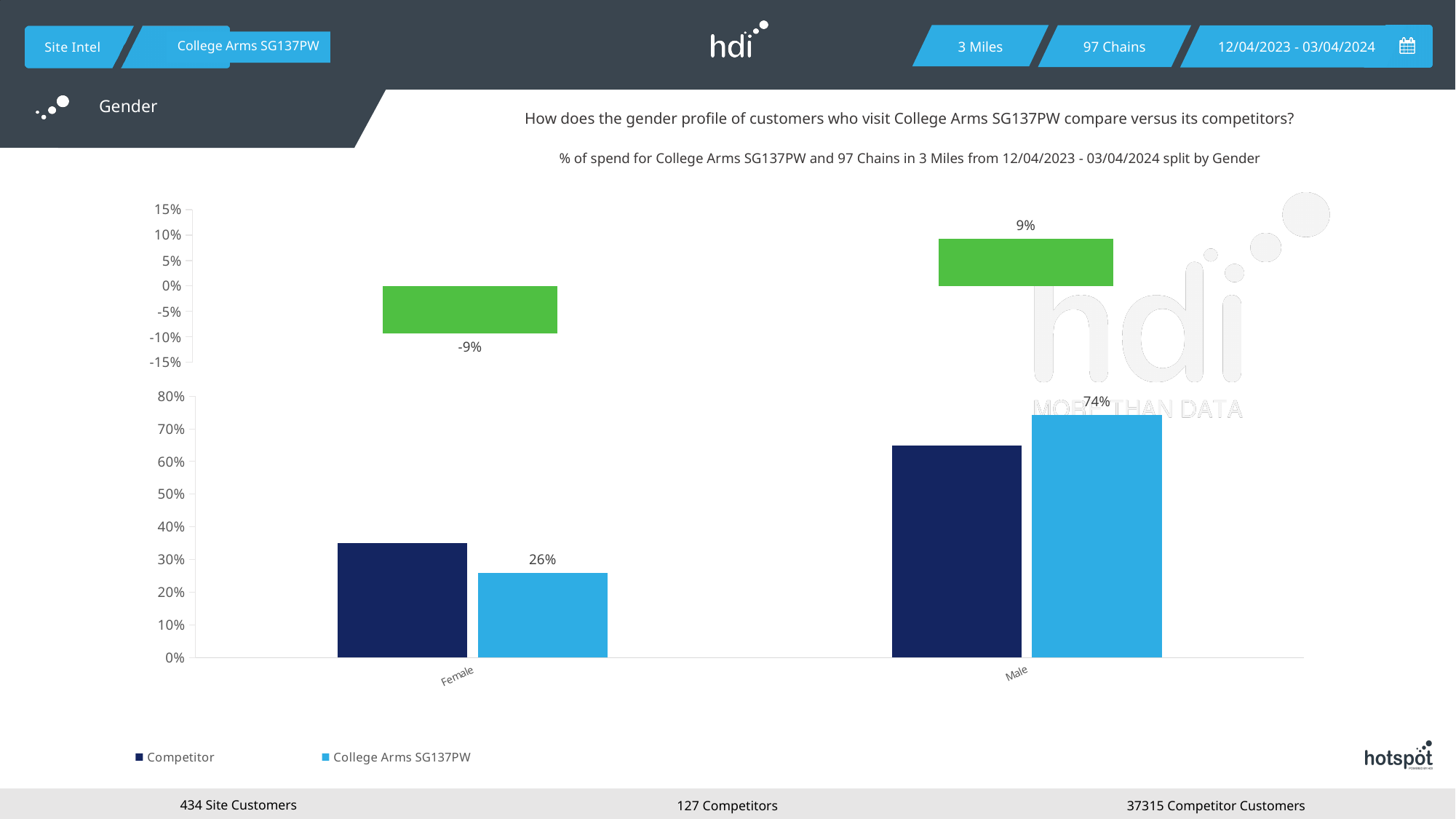
In the bottom bar chart, what is the value for College Arms SG137PW for Male? 74% In the bottom bar chart, what is the value for College Arms SG137PW for Female? 26% In the bottom bar chart, what is the difference between the College Arms SG137PW values for Male and Female? 48% In the bottom bar chart, is the Competitor value for Female greater or less than 30%? greater What kind of chart is the bottom chart? Bar chart In the bottom bar chart, is the Competitor value for Male greater or less than 70%? less In the top chart, what is the value shown for Female? -9% In the bottom bar chart, for Male, which is larger: Competitor or College Arms SG137PW? College Arms SG137PW How many categories are shown on the x axis of the bottom bar chart? 2 In the top chart, what is the value shown for Male? 9% How many series does the legend of the bottom bar chart list? 2 In the bottom bar chart, which category has the highest value for College Arms SG137PW? Male